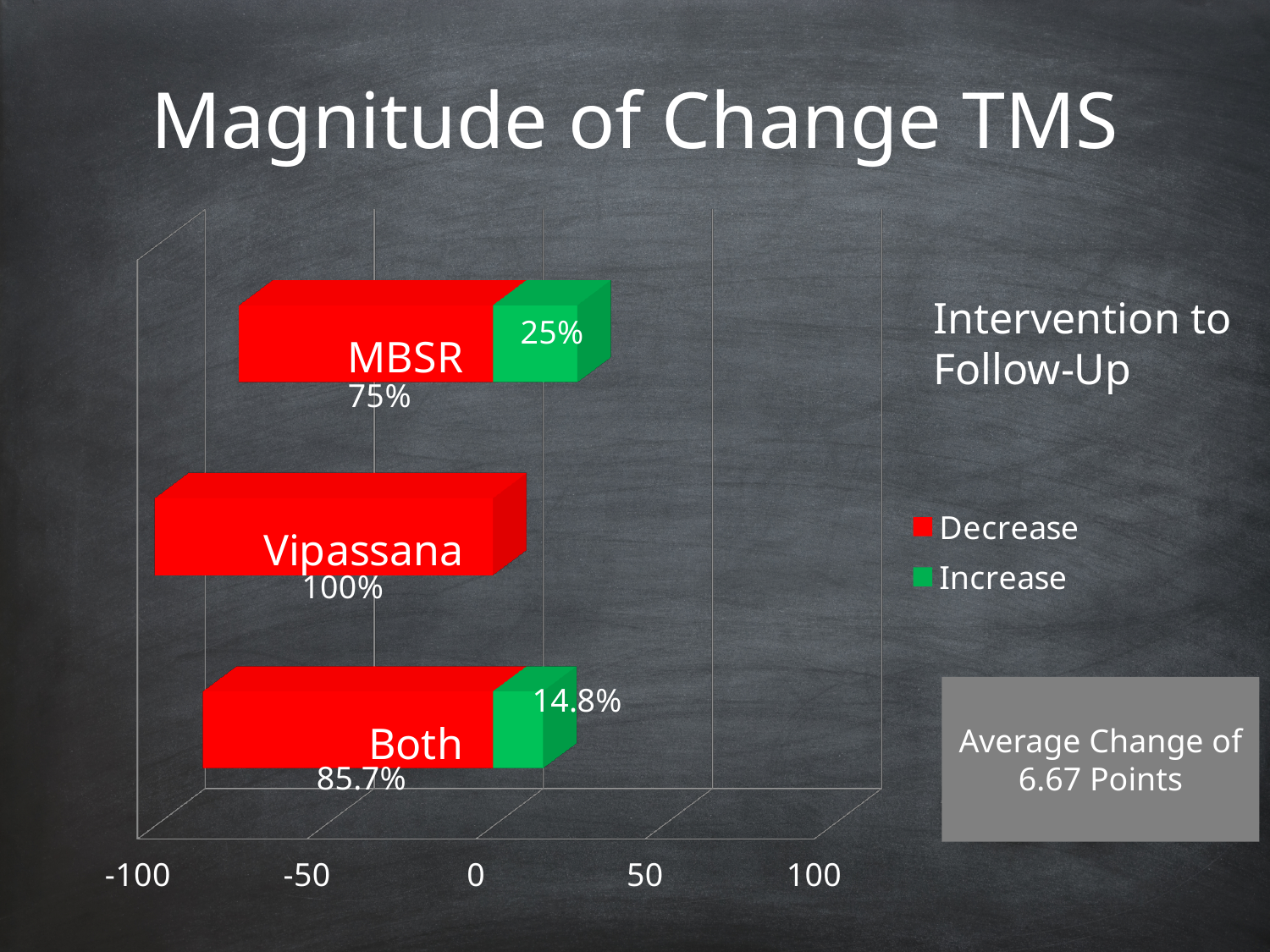
What is the Increase value for Both? 14.8% How many series does the legend list? 2 How many categories are shown on the chart? 3 Which category has the lowest Decrease value? MBSR What is the Decrease value for Both? 85.7% What is the Decrease value for Vipassana? 100% What is the Decrease value for MBSR? 75% Which is larger, the Increase value for MBSR or the Increase value for Both? MBSR What is the Increase value for MBSR? 25% What is the difference between the Decrease values for Vipassana and MBSR? 25% Which category has the highest Decrease value? Vipassana What kind of chart is shown on the slide? Bar chart